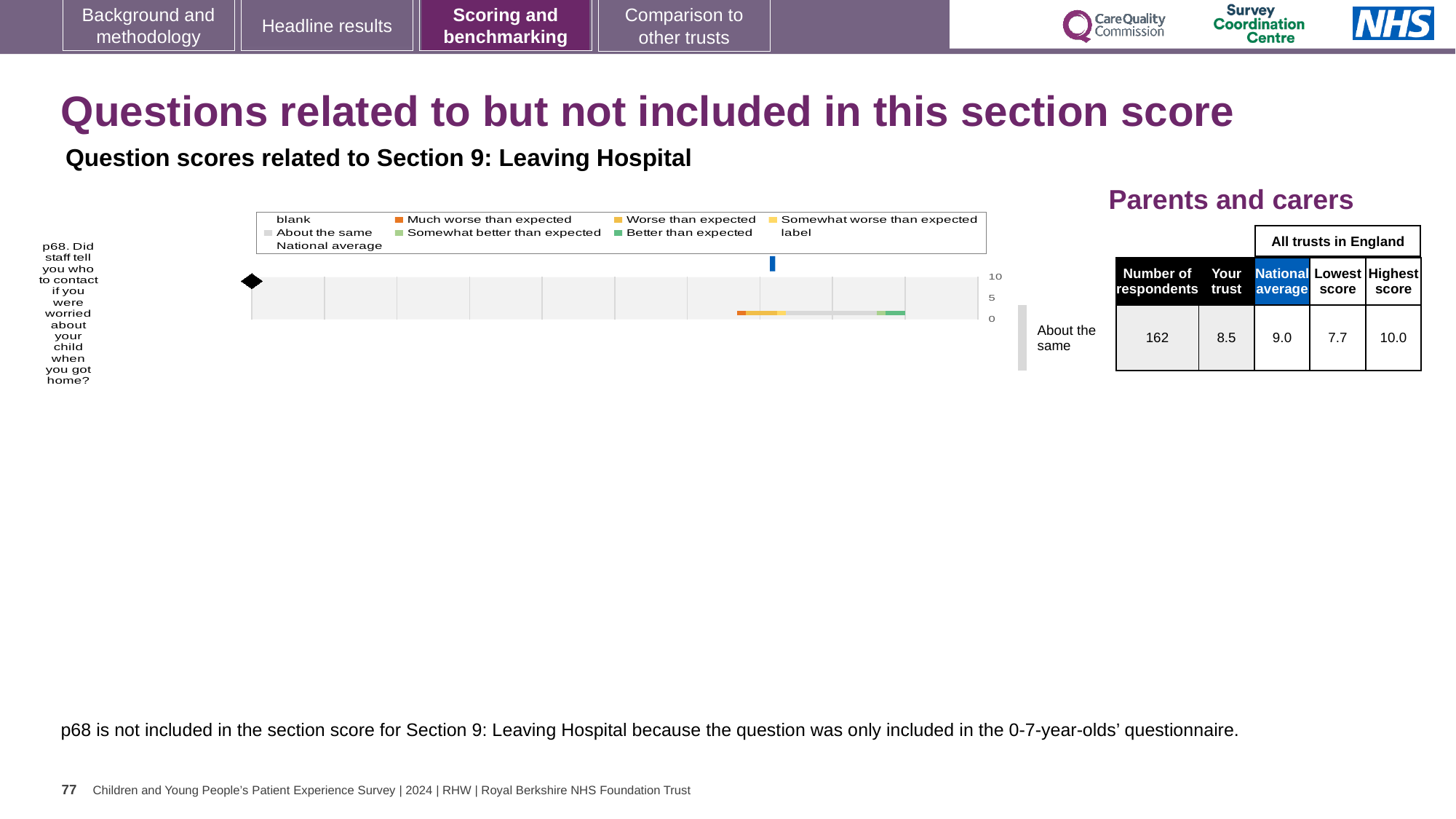
What is the 'Your trust' score for p68? 8.5 Which is larger for p68: the 'Your trust' score or the national average? National average How many respondents answered p68? 162 How many entries does the chart legend list? 9 What is the national average score for p68? 9.0 Which question is plotted in the chart? p68. Did staff tell you who to contact if you were worried about your child when you got home? What kind of chart is shown on the slide? bar chart What is the lowest score among all trusts in England for p68? 7.7 How many questions (categories) are plotted in the chart? 1 What colour does the legend use for 'Much worse than expected'? orange What is the highest score among all trusts in England for p68? 10.0 What is the difference between the national average (9.0) and the 'Your trust' score (8.5) for p68? 0.5